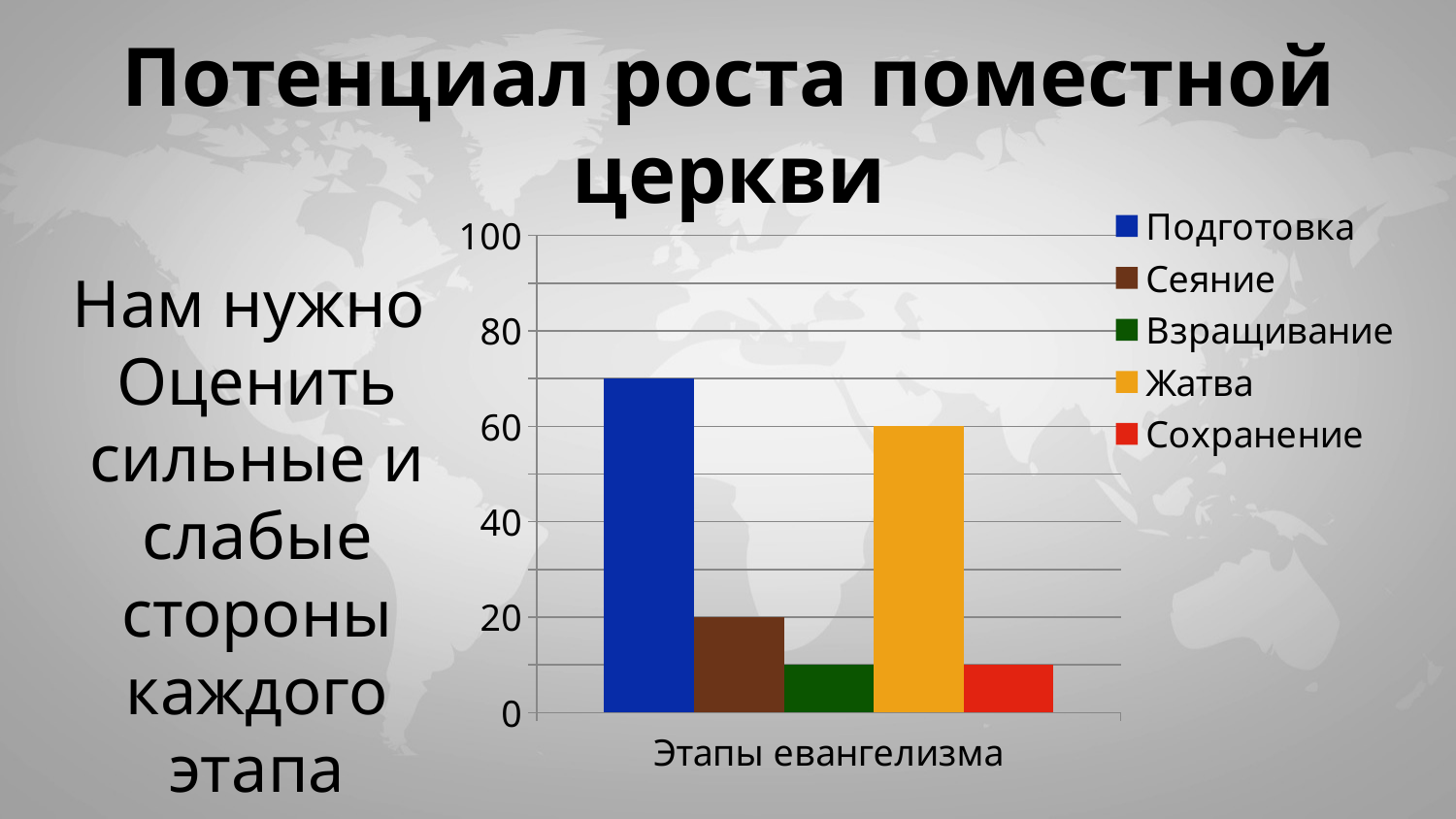
What type of chart is shown on the slide? bar chart What is the difference between the values for Жатва and Сеяние? 40 Is the value for Сохранение greater or less than 20? less What is the value for Жатва? 60 How many series does the legend list? 5 Is the value for Подготовка greater or less than 60? greater Is the value for Взращивание greater or less than 20? less What is the value for Сеяние? 20 Which series has the highest value? Подготовка What colour is the bar for Жатва? yellow Which is larger, the value for Подготовка or the value for Жатва? Подготовка What is the label on the x axis of the chart? Этапы евангелизма